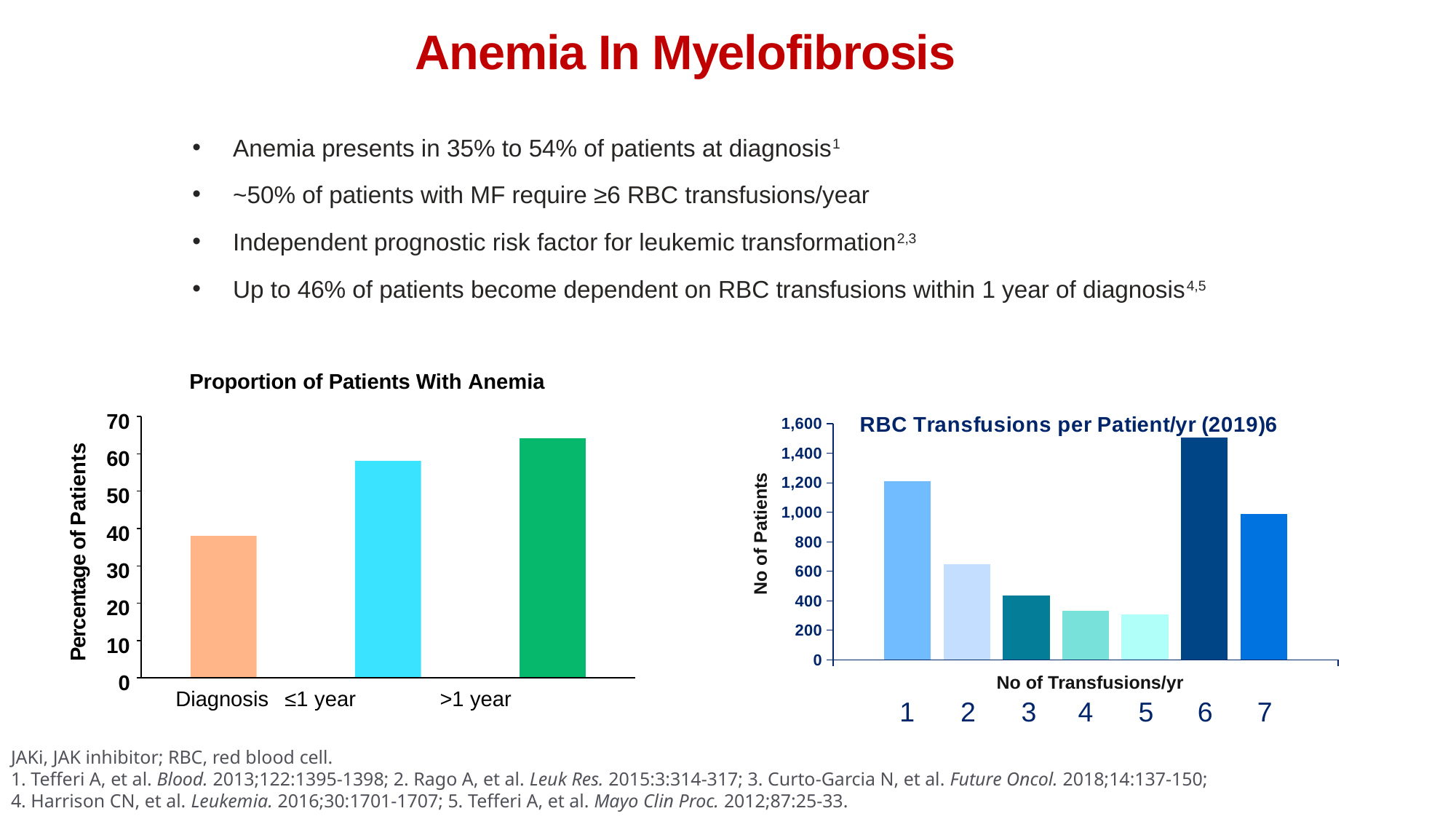
In the 'Proportion of Patients With Anemia' chart, which category has the highest percentage of patients? >1 year What kind of chart is the 'Proportion of Patients With Anemia' chart? bar chart In the 'RBC Transfusions per Patient/yr (2019)' chart, which number of transfusions per year has the highest number of patients? 6 How many categories are shown on the x axis of the 'Proportion of Patients With Anemia' chart? 3 In the 'RBC Transfusions per Patient/yr (2019)' chart, is the number of patients for 1 transfusion/yr greater or less than 1,000? greater What is the y-axis label of the 'Proportion of Patients With Anemia' chart? Percentage of Patients In the 'RBC Transfusions per Patient/yr (2019)' chart, which has more patients: 2 transfusions/yr or 7 transfusions/yr? 7 In the 'Proportion of Patients With Anemia' chart, which category has the lowest percentage of patients? Diagnosis In the 'Proportion of Patients With Anemia' chart, do the values rise or fall from Diagnosis to >1 year? rise In the 'RBC Transfusions per Patient/yr (2019)' chart, which number of transfusions per year has the lowest number of patients? 5 How many categories are shown on the x axis of the 'RBC Transfusions per Patient/yr (2019)' chart? 7